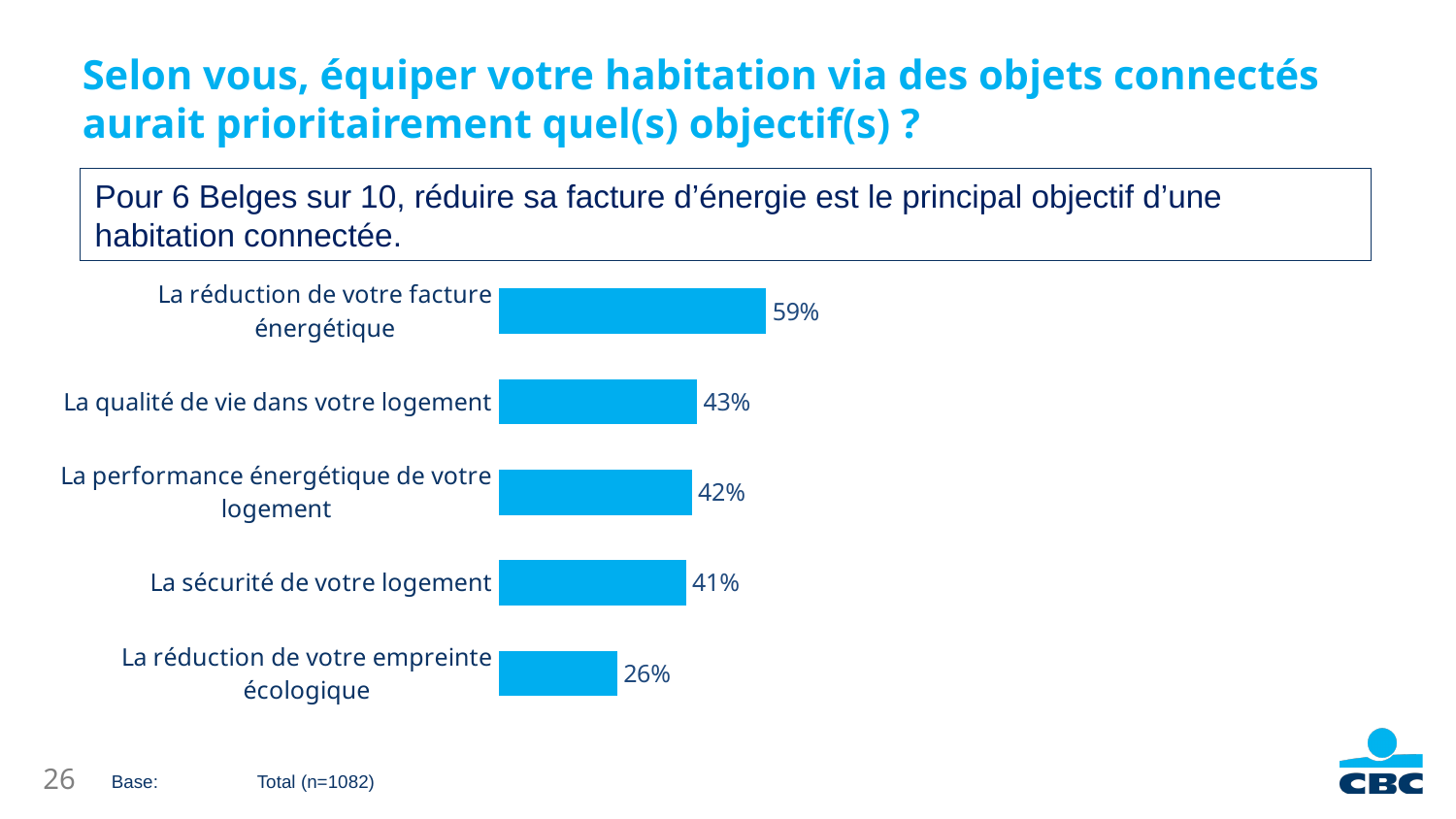
What kind of chart is shown on the slide? Bar chart What percentage is shown for 'La réduction de votre empreinte écologique'? 26% Which is larger: the value for 'La qualité de vie dans votre logement' or 'La réduction de votre empreinte écologique'? La qualité de vie dans votre logement What percentage is shown for 'La sécurité de votre logement'? 41% What is the sample size (base) stated on the slide? Total (n=1082) What is the difference between the values for 'La sécurité de votre logement' and 'La réduction de votre empreinte écologique'? 15 percentage points Which category has the highest value? La réduction de votre facture énergétique What is the difference between the values for 'La réduction de votre facture énergétique' and 'La qualité de vie dans votre logement'? 16 percentage points What is the value for 'La performance énergétique de votre logement'? 42% How many categories are shown in the chart? 5 Which category has the lowest value? La réduction de votre empreinte écologique What percentage is shown for 'La réduction de votre facture énergétique'? 59%